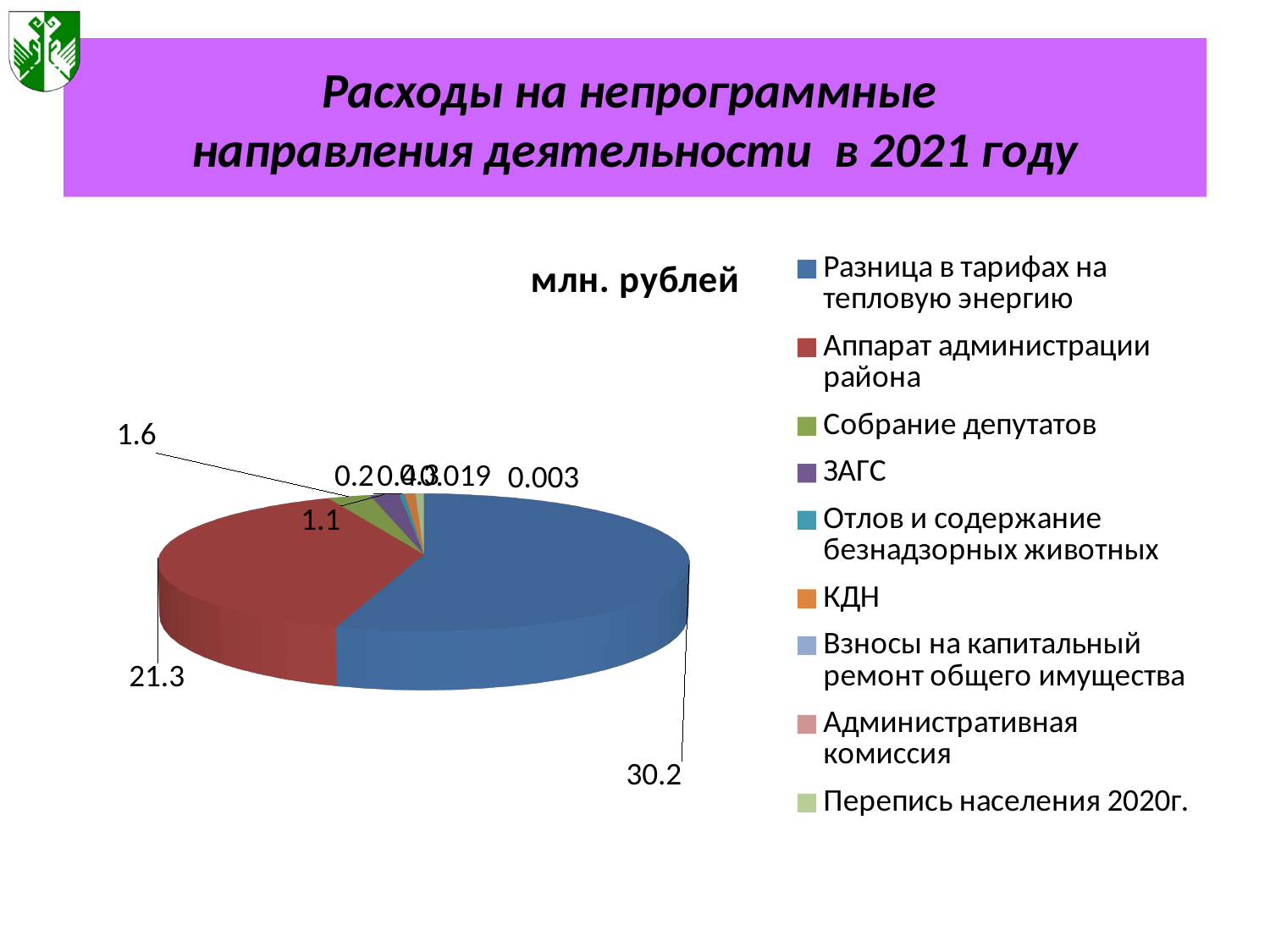
Which is larger: Собрание депутатов or Аппарат администрации района? Аппарат администрации района What value is shown for Аппарат администрации района? 21.3 What value is shown for Разница в тарифах на тепловую энергию? 30.2 What colour is the slice for Разница в тарифах на тепловую энергию? Blue What is the difference between the values for Разница в тарифах на тепловую энергию and Аппарат администрации района? 8.9 What kind of chart is shown on the slide? Pie chart How many categories does the legend list? 9 What is the title of the chart? млн. рублей Which category has the largest slice of the pie? Разница в тарифах на тепловую энергию Which is larger: Аппарат администрации района or Разница в тарифах на тепловую энергию? Разница в тарифах на тепловую энергию How many data series does the chart plot? 1